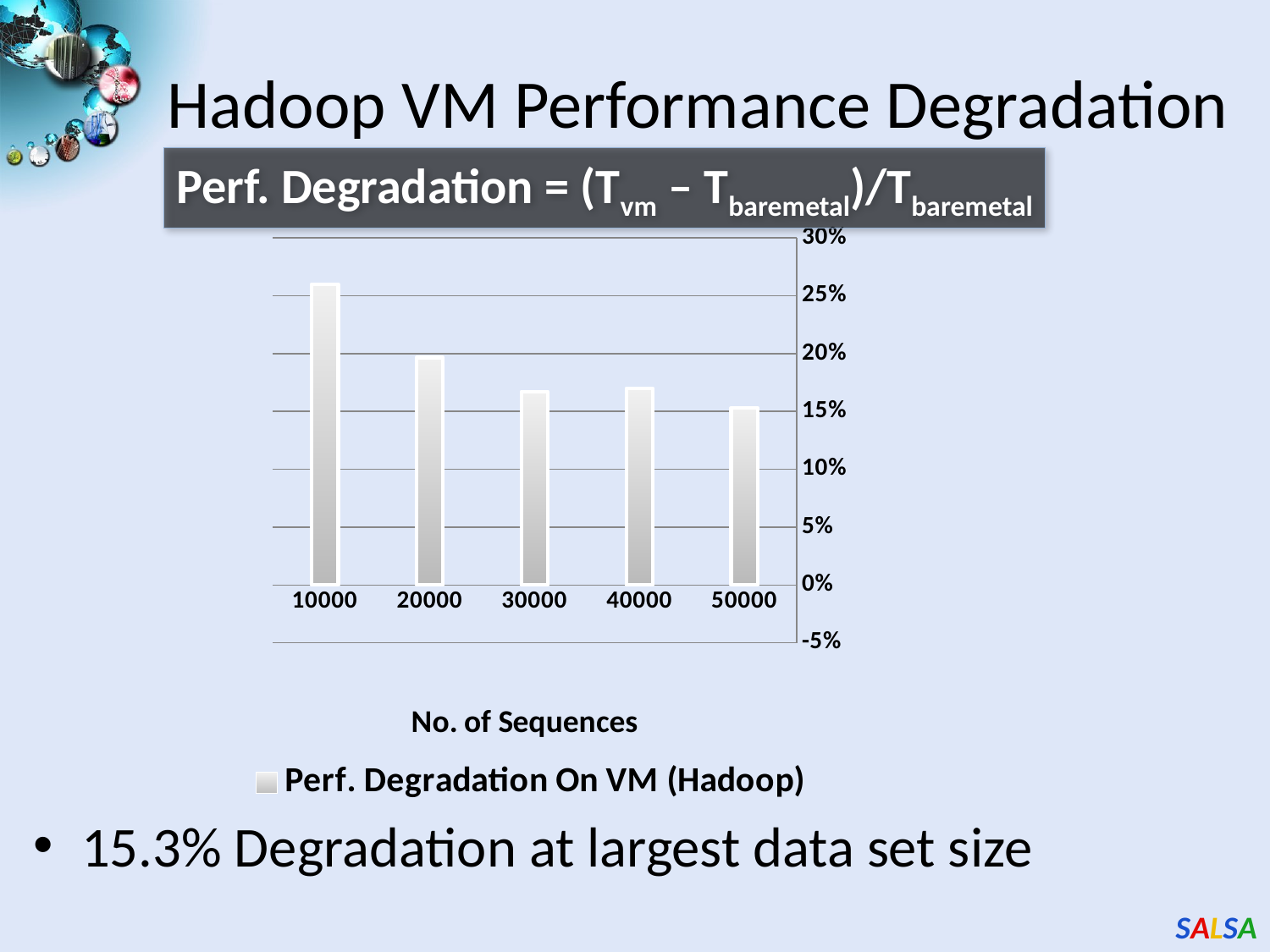
What kind of chart is shown on the slide? bar chart What is the title of the x axis? No. of Sequences Is the performance degradation for 30000 sequences greater or less than 20%? less Is the performance degradation for 10000 sequences greater or less than 25%? greater Which number of sequences has the lowest performance degradation? 50000 Which number of sequences has the highest performance degradation? 10000 How many categories are plotted along the x axis? 5 What series name is shown in the legend? Perf. Degradation On VM (Hadoop) Which has a larger performance degradation, 10000 or 20000 sequences? 10000 How many series does the legend list? 1 Do the performance degradation values generally rise or fall as the number of sequences increases? fall